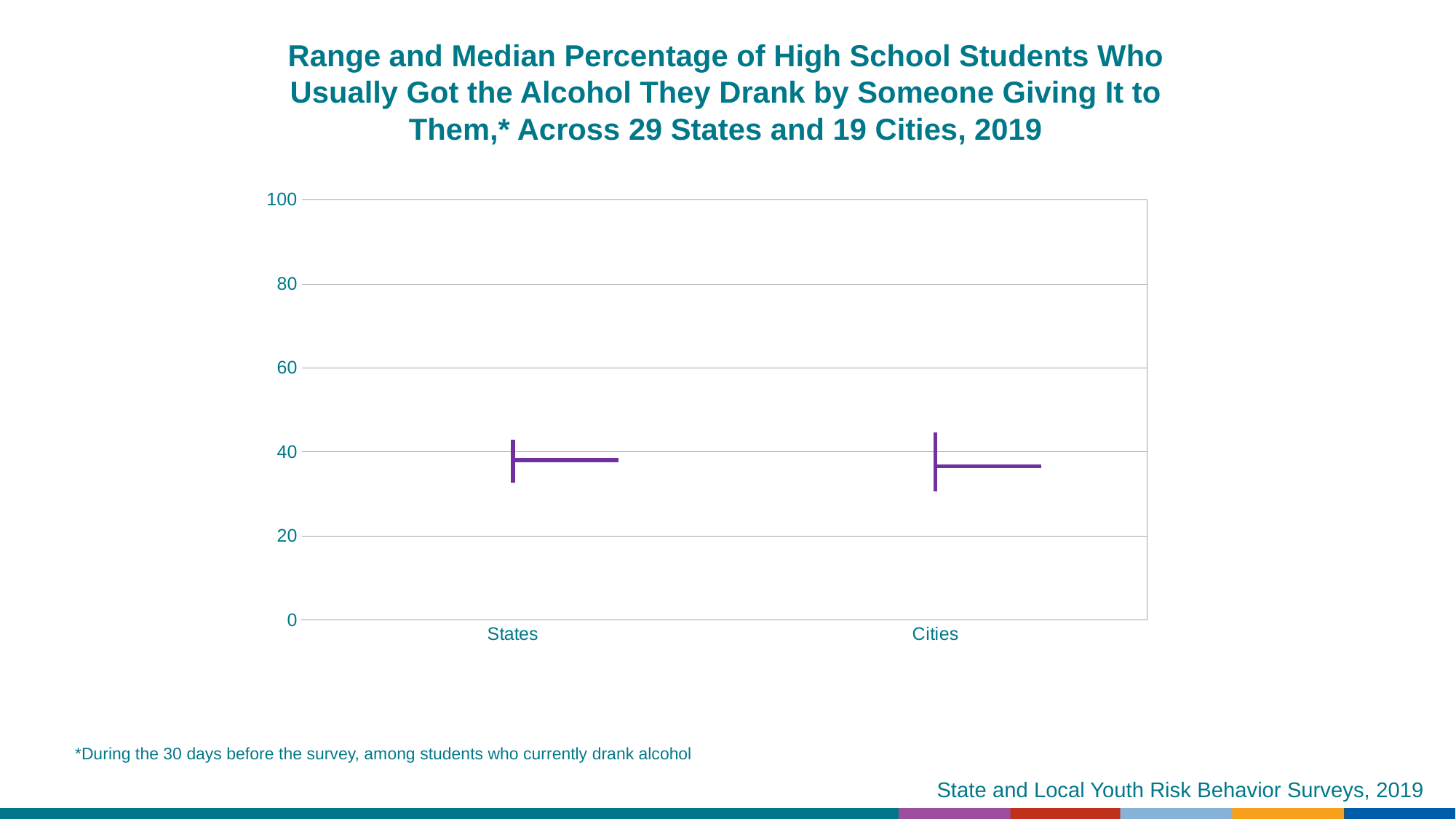
Is the top of the range for States greater or less than 40? greater Is the median value for Cities greater or less than 40? less Is the top of the range for Cities greater or less than 40? greater What year does the chart title say the data are from? 2019 What is the highest value shown on the y axis of the chart? 100 What are the two categories shown on the x axis? States and Cities How many categories are shown on the x axis of the chart? 2 Which category shows a wider range of values, States or Cities? Cities